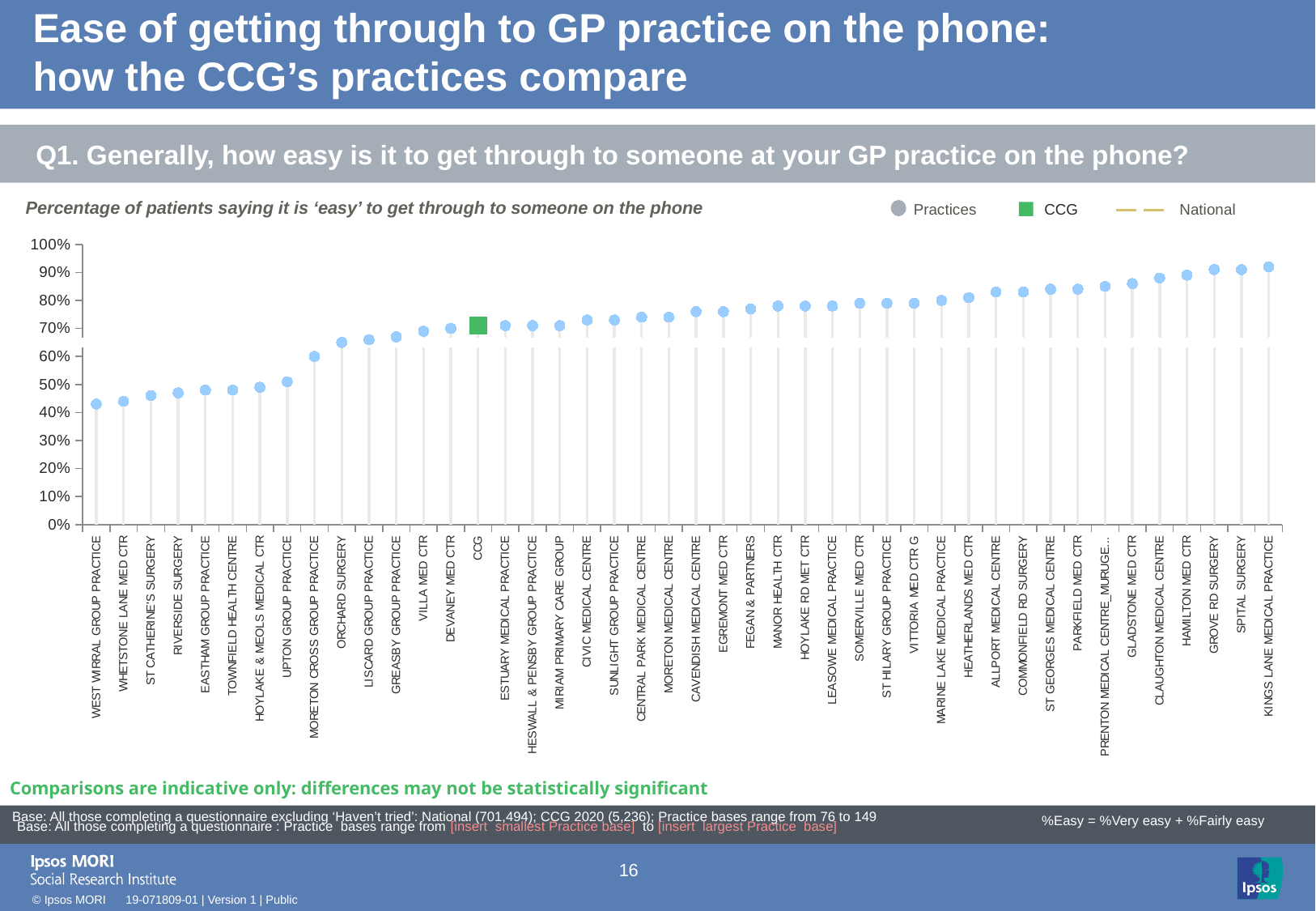
Which has a higher value, ORCHARD SURGERY or RIVERSIDE SURGERY? ORCHARD SURGERY Is the value for WEST WIRRAL GROUP PRACTICE greater or less than 50%? less Is the value for ORCHARD SURGERY greater or less than 60%? greater Do the values rise or fall moving from left to right along the x axis? rise How many entries does the legend list? 3 Is the value for CCG greater or less than 60%? greater What colour is the marker used for the CCG in the chart? green Which practice has the highest percentage of patients saying it is 'easy' to get through on the phone? KINGS LANE MEDICAL PRACTICE Which practice has the lowest percentage of patients saying it is 'easy' to get through on the phone? WEST WIRRAL GROUP PRACTICE